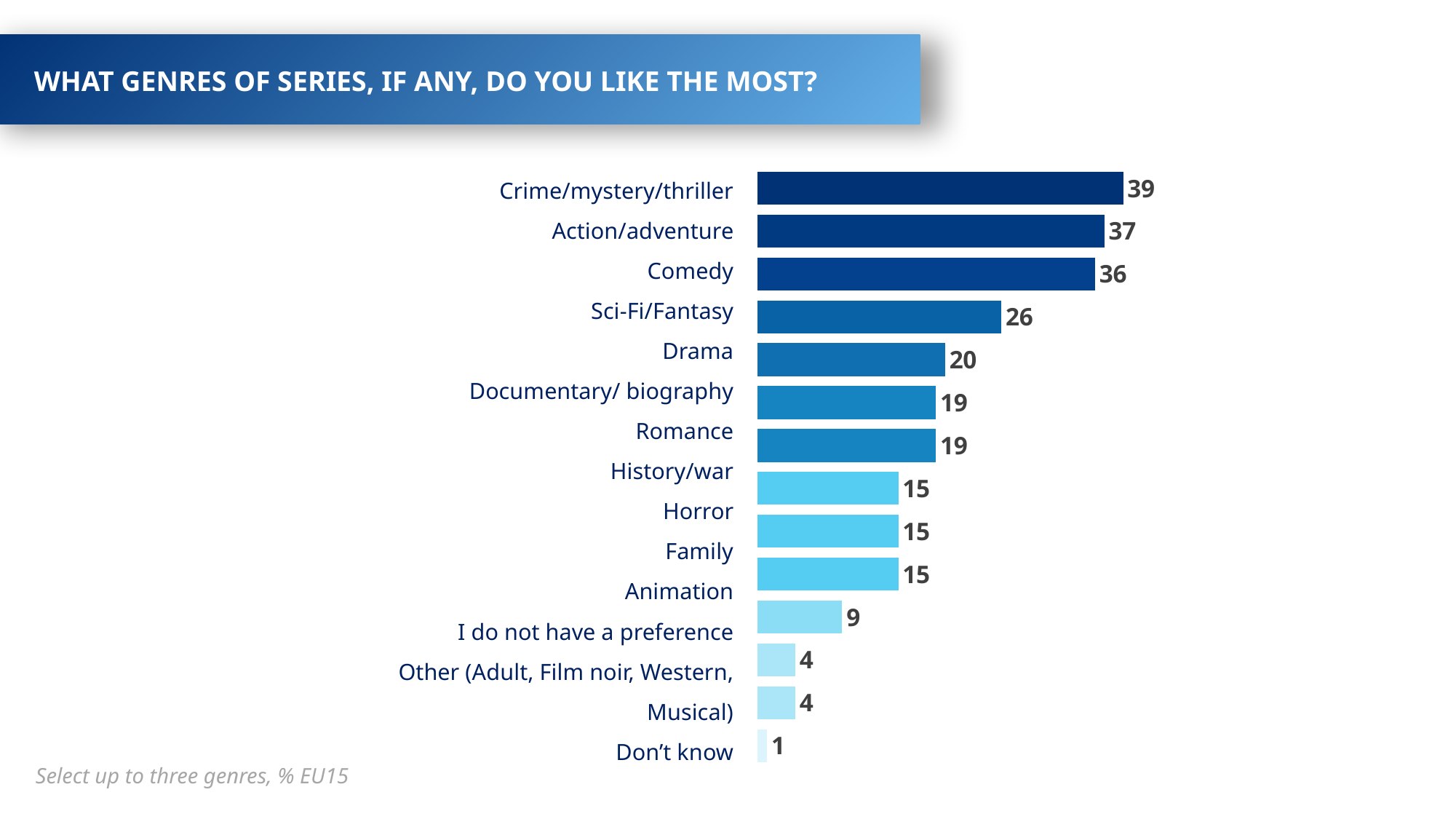
Which category has the lowest value? Don't know What is the value for Sci-Fi/Fantasy? 26 What kind of chart is shown on the slide? Bar chart What is the value for Crime/mystery/thriller? 39 What is the title of the chart? What genres of series, if any, do you like the most? What is the value for Don't know? 1 What is the value for Comedy? 36 Which genre has the highest value? Crime/mystery/thriller What is the difference between the values for Crime/mystery/thriller and Action/adventure? 2 How many bars are shown in the chart? 14 What is the value for Drama? 20 Which is larger, the value for Comedy or the value for Sci-Fi/Fantasy? Comedy